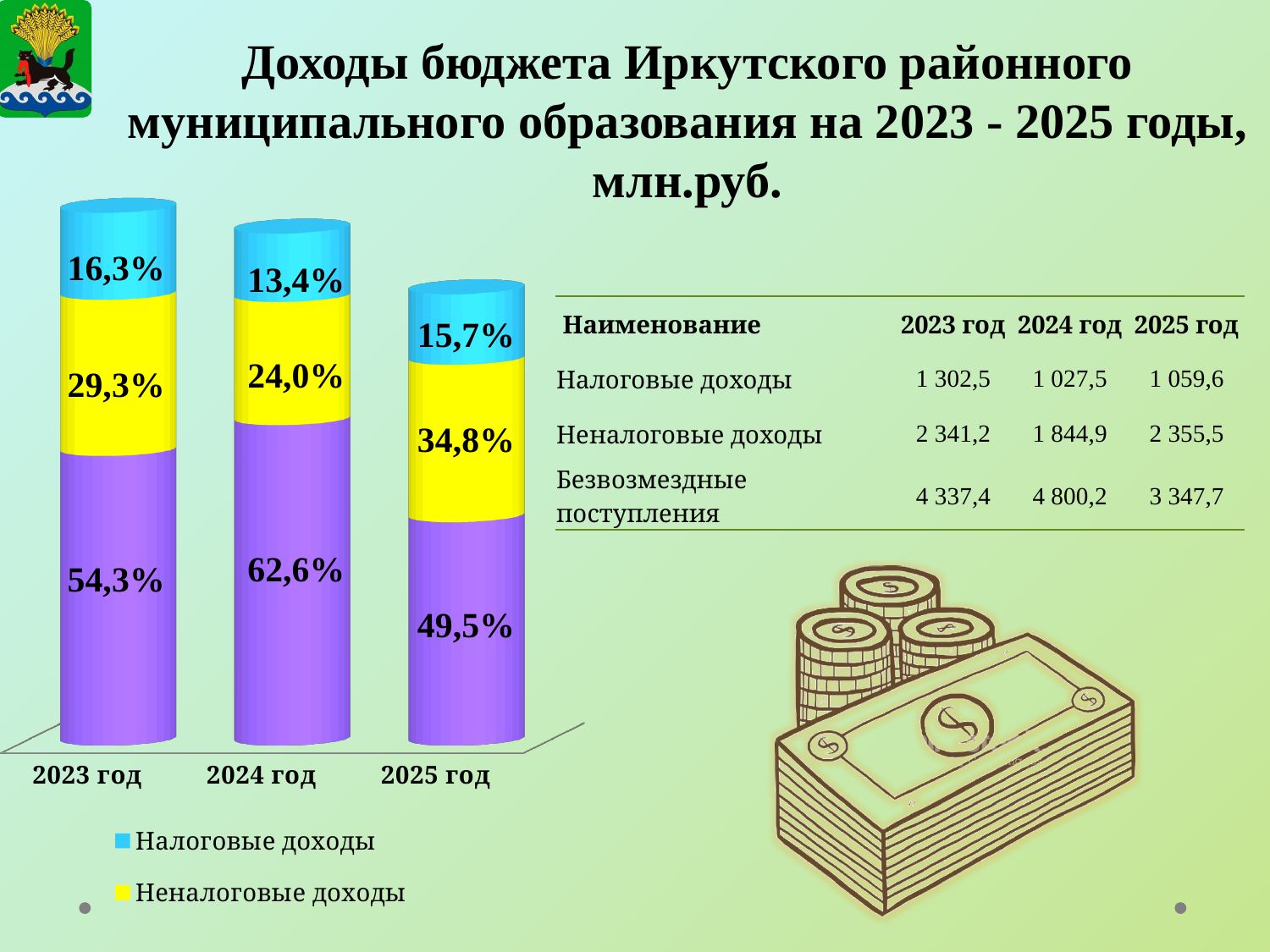
What type of chart is shown on the slide? Stacked bar chart What percentage is printed on the bottom purple segment of the 2024 год bar? 62,6% What is the share of Налоговые доходы in 2023 год shown on the chart? 16,3% Which is larger: the Налоговые доходы share in 2023 год or in 2025 год? 2023 год How many years (bars) are shown on the chart? 3 Which colour represents Налоговые доходы in the chart legend? Blue What is the share of Неналоговые доходы in 2025 год shown on the chart? 34,8% What is the difference between the Неналоговые доходы share in 2025 год and in 2024 год? 10,8% In which year is the share of Неналоговые доходы the highest? 2025 год What is the share of Налоговые доходы in 2024 год shown on the chart? 13,4% In which year is the share of Налоговые доходы the lowest? 2024 год Does the share of Неналоговые доходы rise or fall from 2023 год to 2024 год? Fall